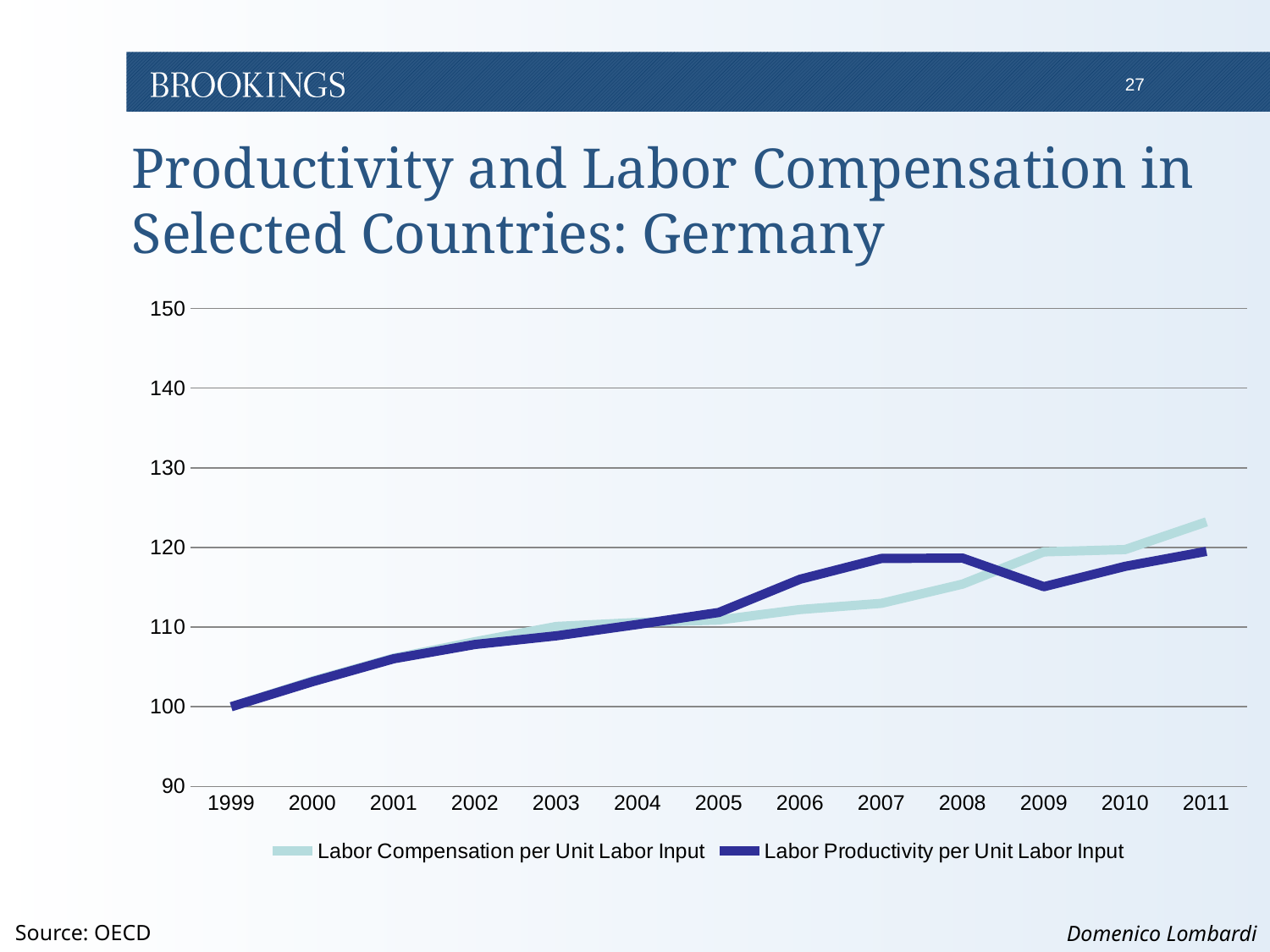
In 2007, which series has the higher value: Labor Compensation per Unit Labor Input or Labor Productivity per Unit Labor Input? Labor Productivity per Unit Labor Input How many series does the legend list? 2 What is the title of the slide containing the chart? Productivity and Labor Compensation in Selected Countries: Germany Is the value for Labor Productivity per Unit Labor Input in 2007 greater or less than 110? greater What is the value of Labor Productivity per Unit Labor Input in 1999? 100 How many years are plotted along the x axis? 13 In which year does Labor Compensation per Unit Labor Input reach its highest value? 2011 Does Labor Compensation per Unit Labor Input generally rise or fall from 1999 to 2011? rise What kind of chart is shown on the slide? line chart In 2011, which series has the higher value: Labor Compensation per Unit Labor Input or Labor Productivity per Unit Labor Input? Labor Compensation per Unit Labor Input Is the value for Labor Compensation per Unit Labor Input in 2011 greater or less than 120? greater